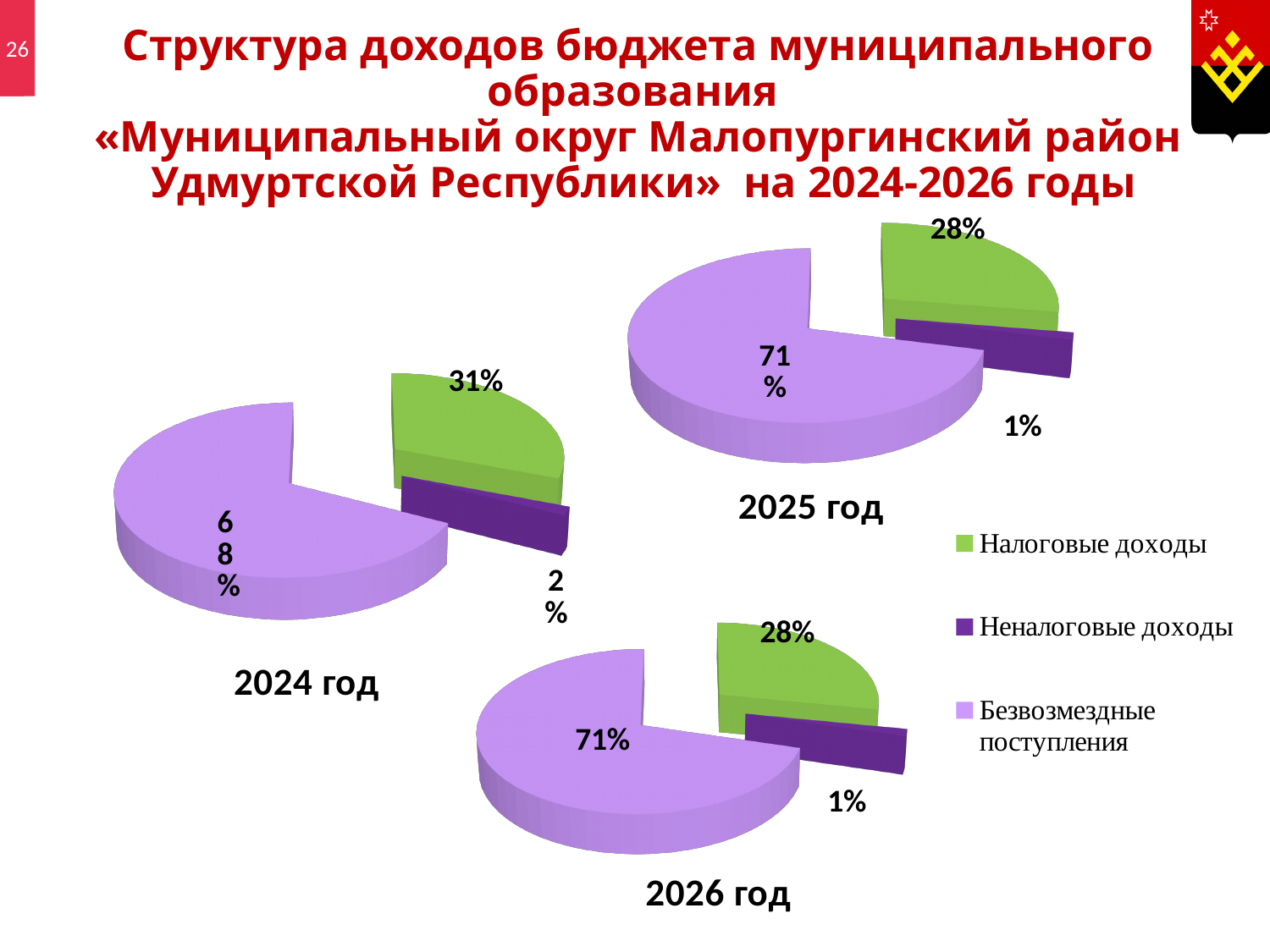
In the 2024 год pie chart, what share is Неналоговые доходы? 2% What kind of chart is used for the 2026 год data? Pie chart Which is larger: the share of Налоговые доходы in the 2024 год chart or in the 2025 год chart? 2024 год In the 2026 год pie chart, what share is Неналоговые доходы? 1% In the 2024 год pie chart, what is the difference between the shares of Безвозмездные поступления and Налоговые доходы? 37% How many categories does the legend list for the pie charts? 3 In the 2026 год pie chart, what share is Налоговые доходы? 28% In the 2024 год pie chart, which category has the smallest share? Неналоговые доходы In the 2024 год pie chart, what share is Безвозмездные поступления? 68% In the 2024 год pie chart, what share is Налоговые доходы? 31% In the 2025 год pie chart, what share is Безвозмездные поступления? 71% In the 2025 год pie chart, which category has the largest share? Безвозмездные поступления